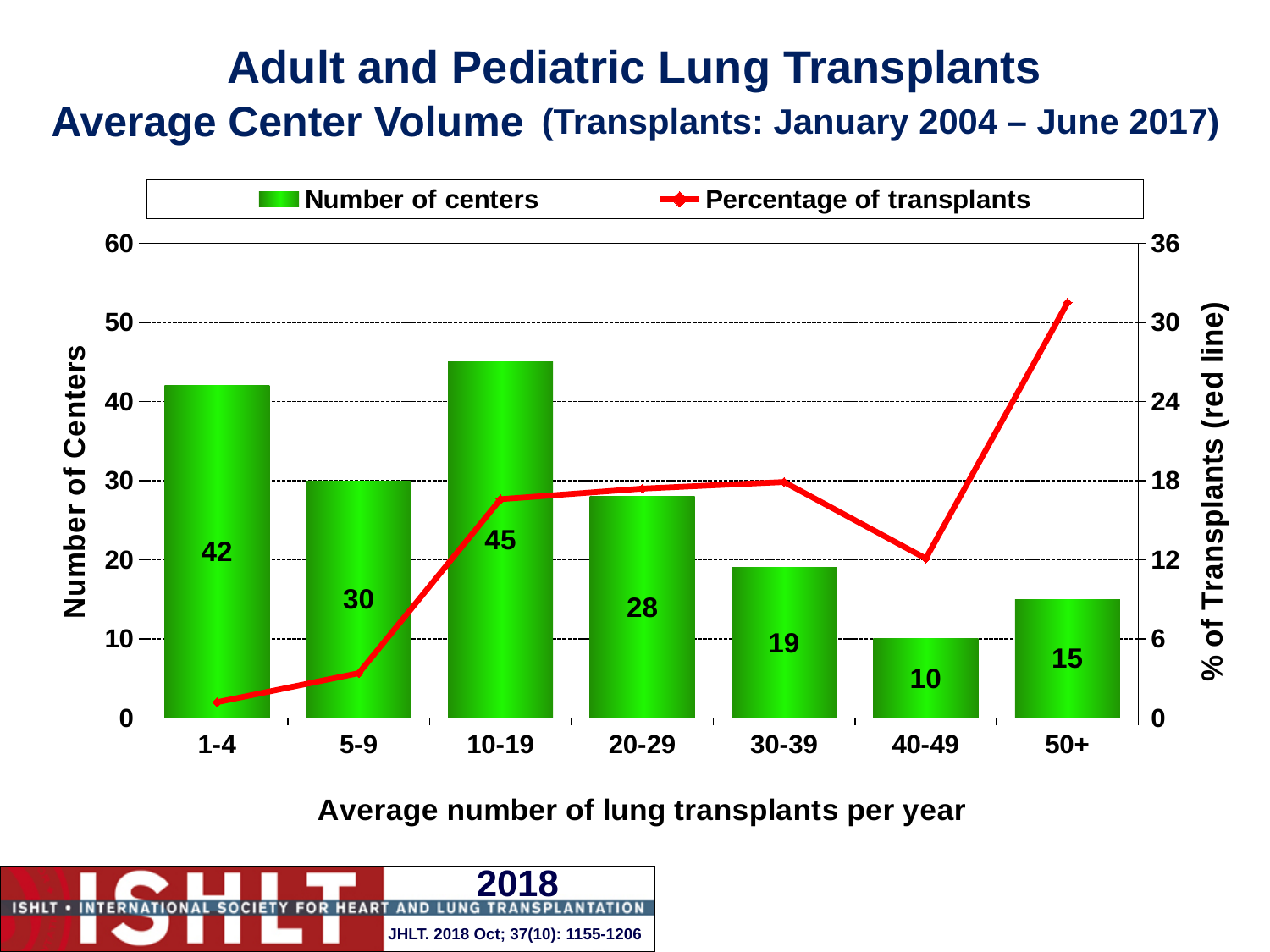
Which category has the highest number of centers? 10-19 What is the difference in number of centers between the 1-4 and 5-9 categories? 12 What is the number of centers for the 40-49 category? 10 Which has more centers, the 20-29 category or the 50+ category? 20-29 How many series does the legend list? 2 Which category has the lowest number of centers? 40-49 How many centers are in the 10-19 average transplants per year category? 45 Is the percentage of transplants for the 50+ category greater or less than 30? greater How many categories of average number of lung transplants per year are shown on the x axis? 7 Is the percentage of transplants for the 1-4 category greater or less than 6? less What is the label of the right-hand vertical axis? % of Transplants (red line) What kind of chart is used to show the number of centers? Bar chart